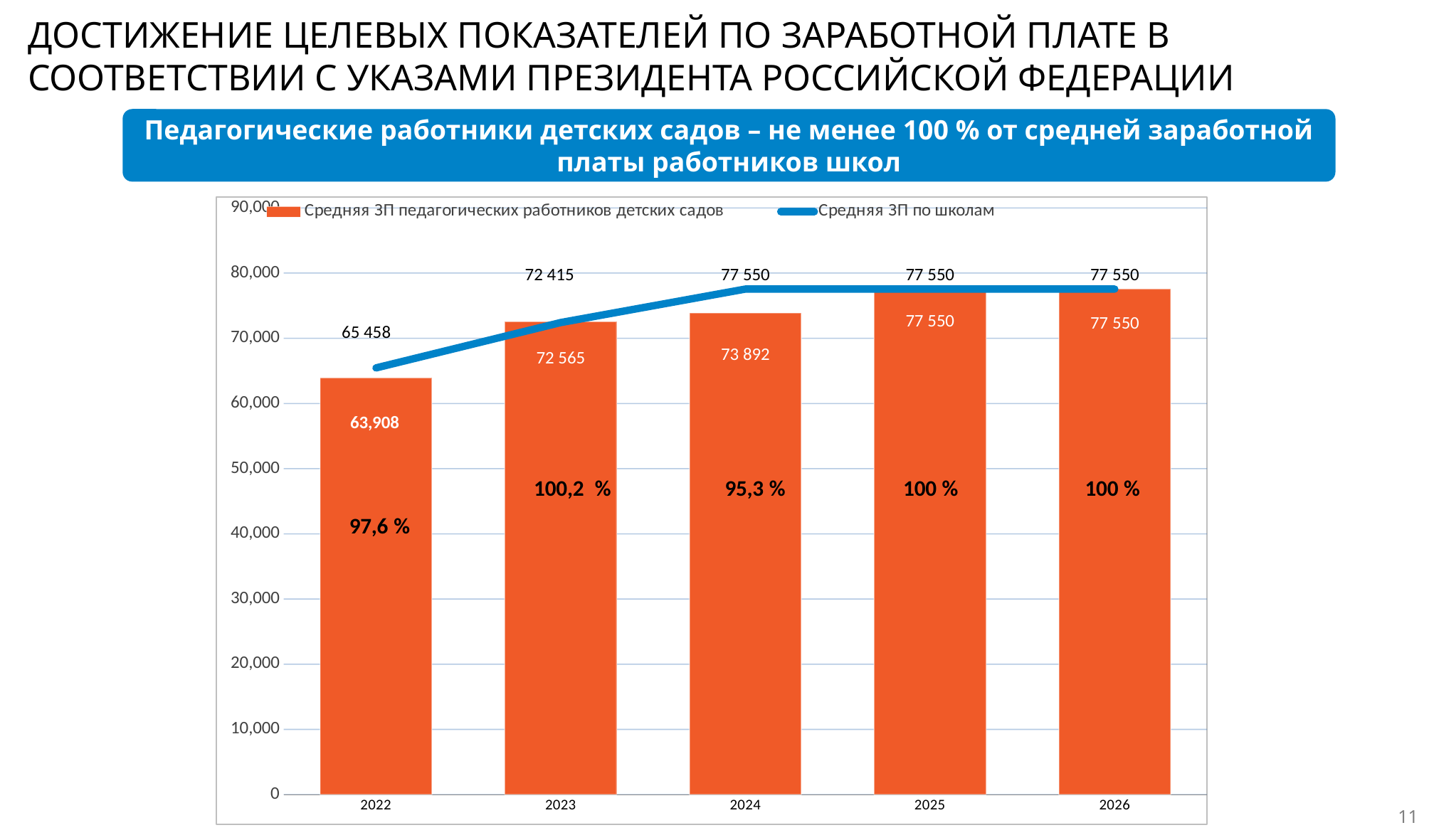
What percentage is printed on the bar for 2023? 100,2 % For 2024, which is larger: the bar value (kindergarten teachers) or the line value (schools)? the line value (77 550) How many years are shown on the x axis? 5 Do the bar values rise or fall from 2022 to 2026? rise What kind of chart is shown on the slide? a bar chart combined with a line What is the difference between the bar value and the line value for 2023? 150 How many series does the legend list? 2 What is the value of the bar for 2024? 73 892 What is the value of the line (Средняя ЗП по школам) for 2023? 72 415 Is the bar value for 2022 greater or less than 60,000? greater Which year has the lowest bar value for kindergarten teachers' average salary? 2022 What is the value of the bar for 2022 (Средняя ЗП педагогических работников детских садов)? 63,908